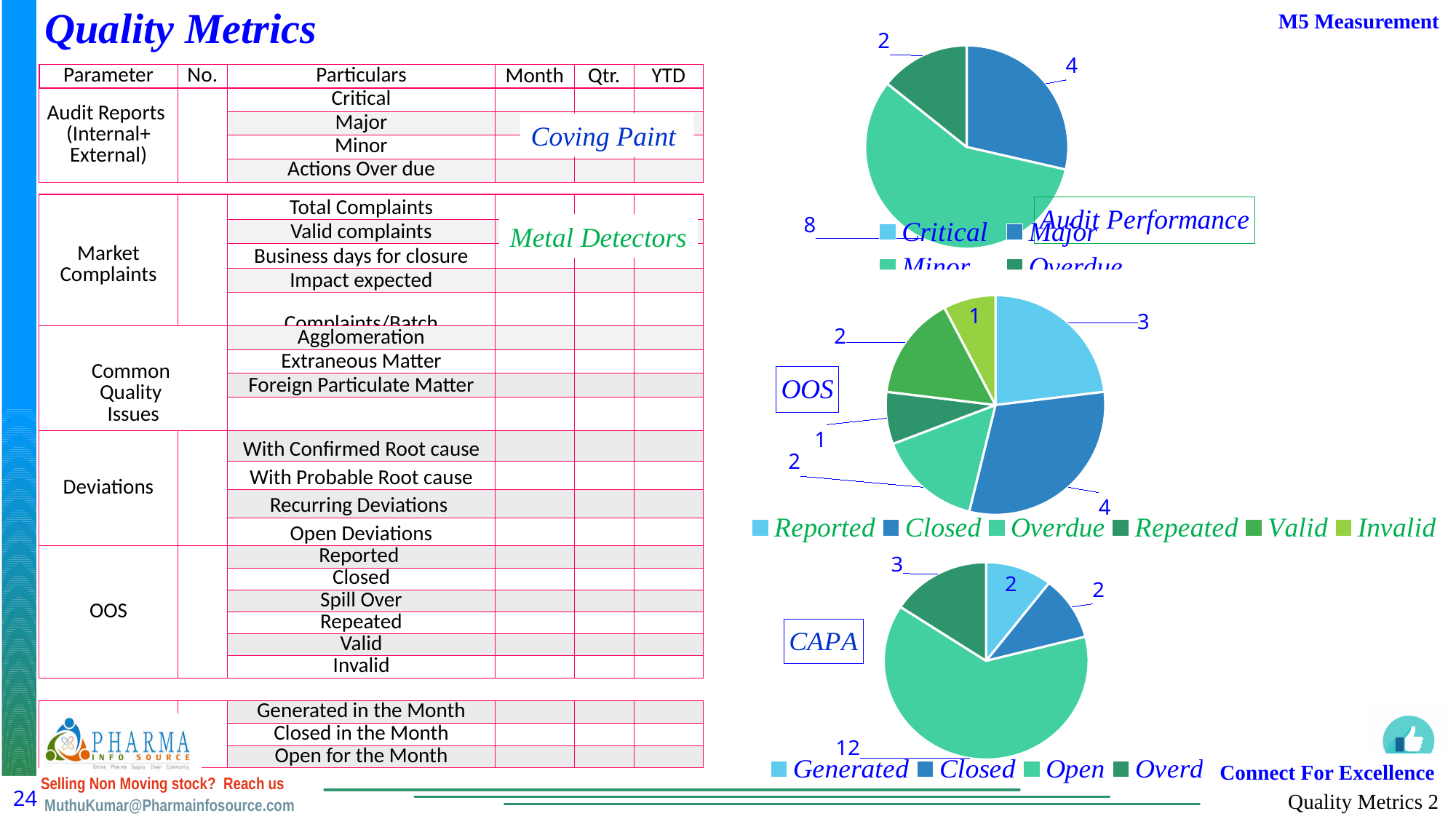
In the CAPA pie chart, which category has the largest slice? Open In the Audit Performance pie chart, what is the difference between the Minor value and the Major value? 4 In the CAPA pie chart, what is the value for Open? 12 In the OOS pie chart, which category has the largest slice? Closed In the OOS pie chart, what is the value for Reported? 3 In the OOS pie chart, what is the value for Closed? 4 How many categories does the legend of the CAPA pie chart list? 4 In the OOS pie chart, which is larger, Reported or Overdue? Reported What type of chart is the CAPA chart? Pie chart In the Audit Performance pie chart, what is the value for Minor? 8 In the CAPA pie chart, what is the difference between the Open value and the Overdue value? 9 How many categories does the legend of the OOS pie chart list? 6